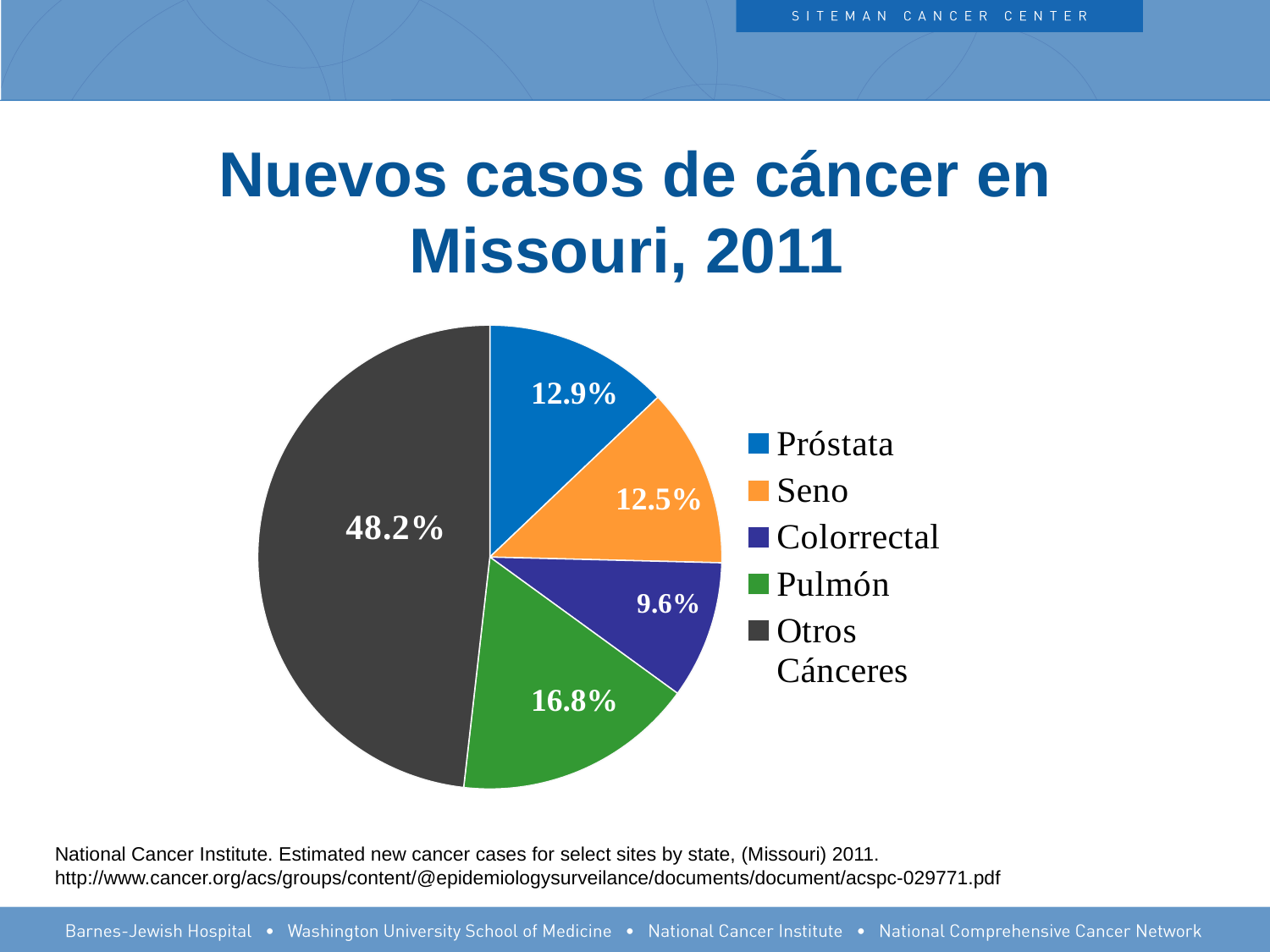
What is the title of the chart? Nuevos casos de cáncer en Missouri, 2011 What share of the pie does Otros Cánceres represent? 48.2% What share of the pie does Colorrectal represent? 9.6% Which category has the smallest slice of the pie? Colorrectal What is the difference in percentage points between Pulmón and Colorrectal? 7.2 Which category has the largest slice of the pie? Otros Cánceres What kind of chart is shown on the slide? Pie chart What share of the pie does Seno represent? 12.5% What share of the pie does Pulmón represent? 16.8% Which is larger, the share for Pulmón or the share for Seno? Pulmón How many categories does the pie chart show? 5 What share of the pie does Próstata represent? 12.9%